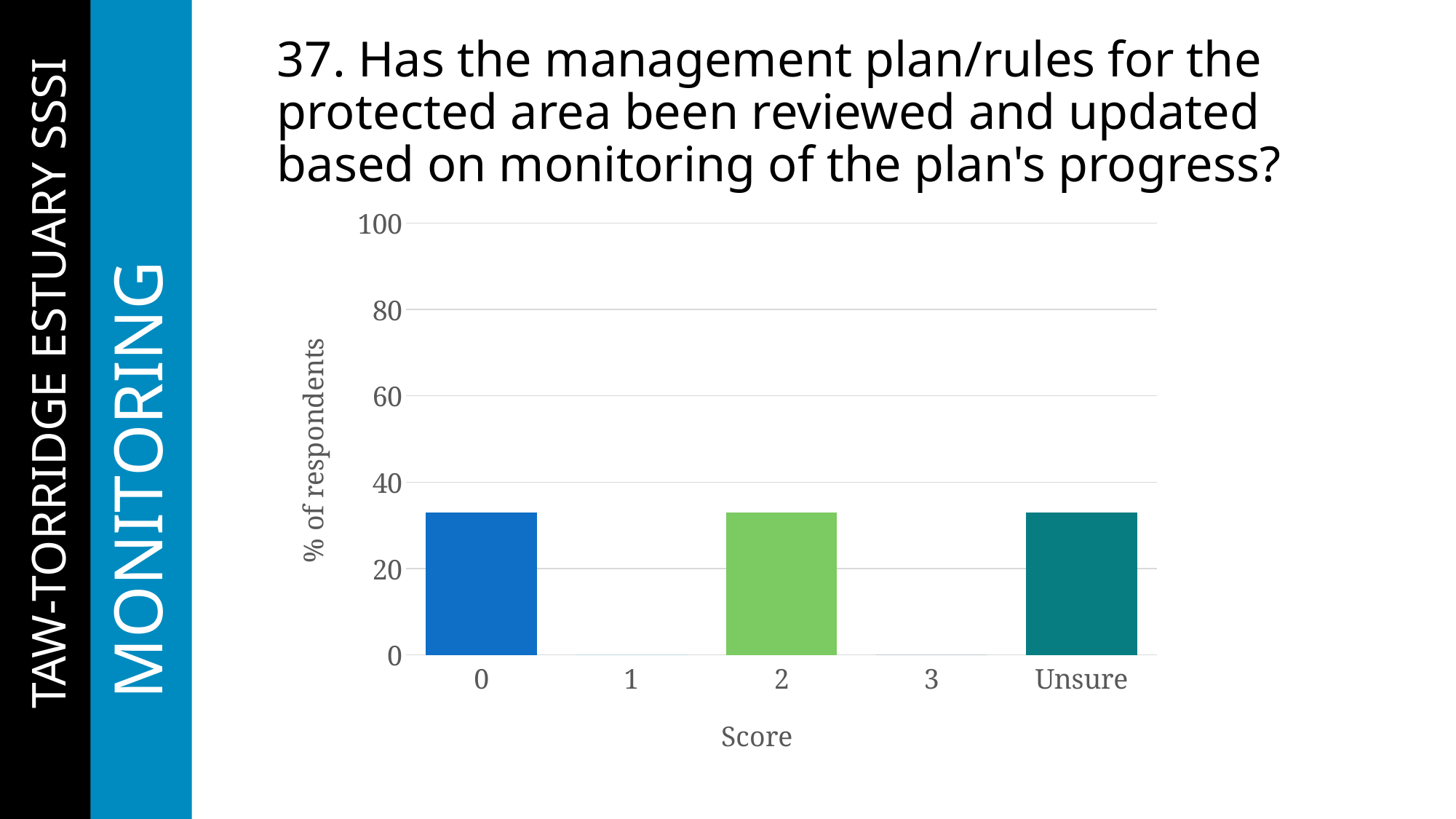
Which has the larger value, score 0 or score 1? 0 Is the value for score 2 greater or less than 40? less Is the value for score 0 greater or less than 20? greater What kind of chart is shown on the slide? bar chart How many score categories are shown on the x axis of the chart? 5 Which has the larger value, score 3 or Unsure? Unsure What is the value for score 3? 0 Is the value for Unsure greater or less than 20? greater What is the label of the horizontal axis of the chart? Score What is the value for score 1? 0 What is the label of the vertical axis of the chart? % of respondents